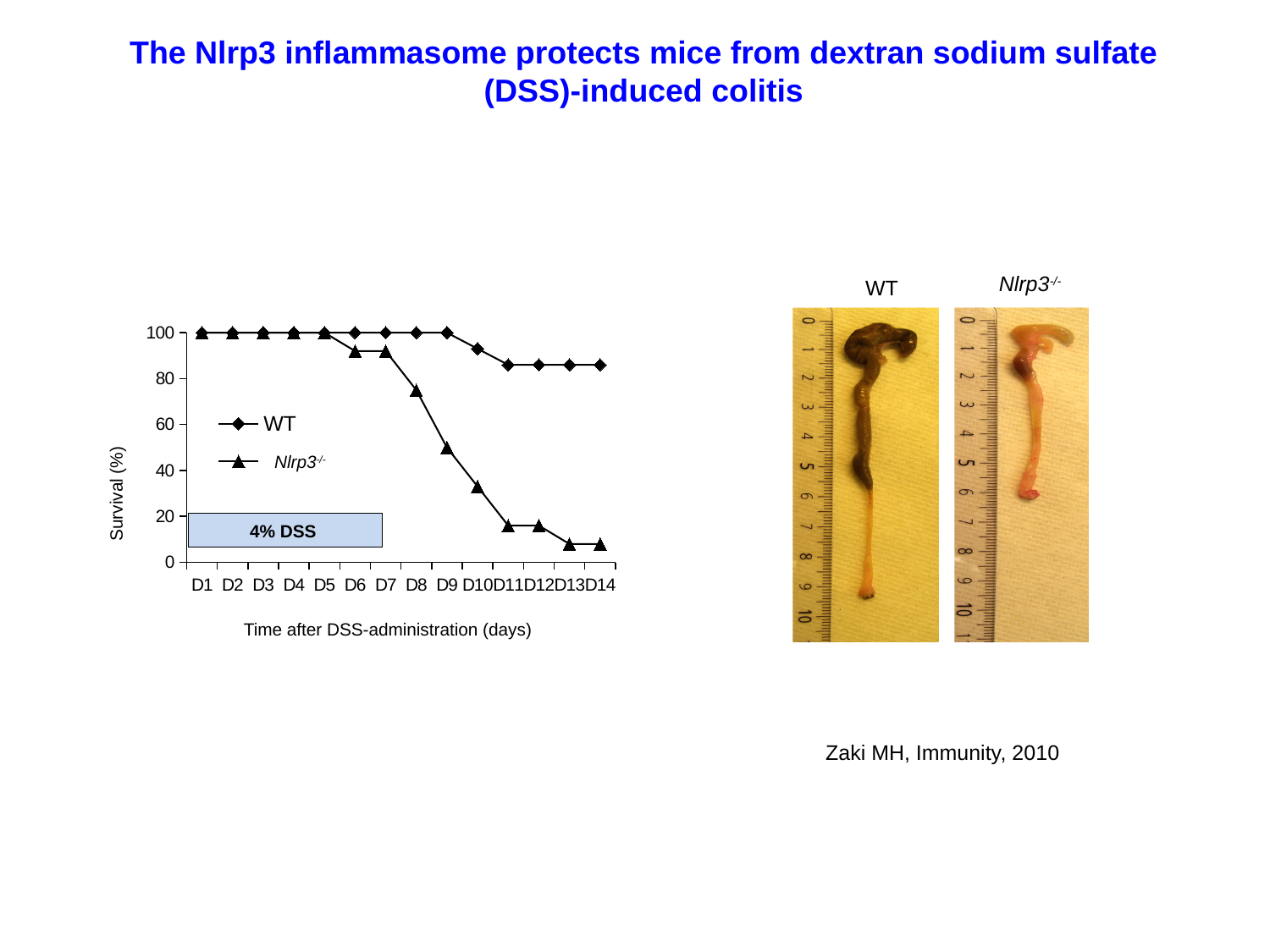
What is the survival (%) for Nlrp3-/- mice at D3? 100 How many series does the chart legend list? 2 What label is shown in the shaded box on the survival chart? 4% DSS What is the x-axis title of the survival chart? Time after DSS-administration (days) What is the survival (%) for WT mice at D5? 100 Does the survival of Nlrp3-/- mice rise or fall from D5 to D14? fall At D12, which series has the higher survival, WT or Nlrp3-/-? WT Is the survival value for Nlrp3-/- mice at D8 greater or less than 60? greater Is the survival value for Nlrp3-/- mice at D11 greater or less than 20? less How many time points are shown on the x axis of the survival chart? 14 What kind of chart is shown on the slide? line chart Is the survival value for WT mice at D14 greater or less than 80? greater